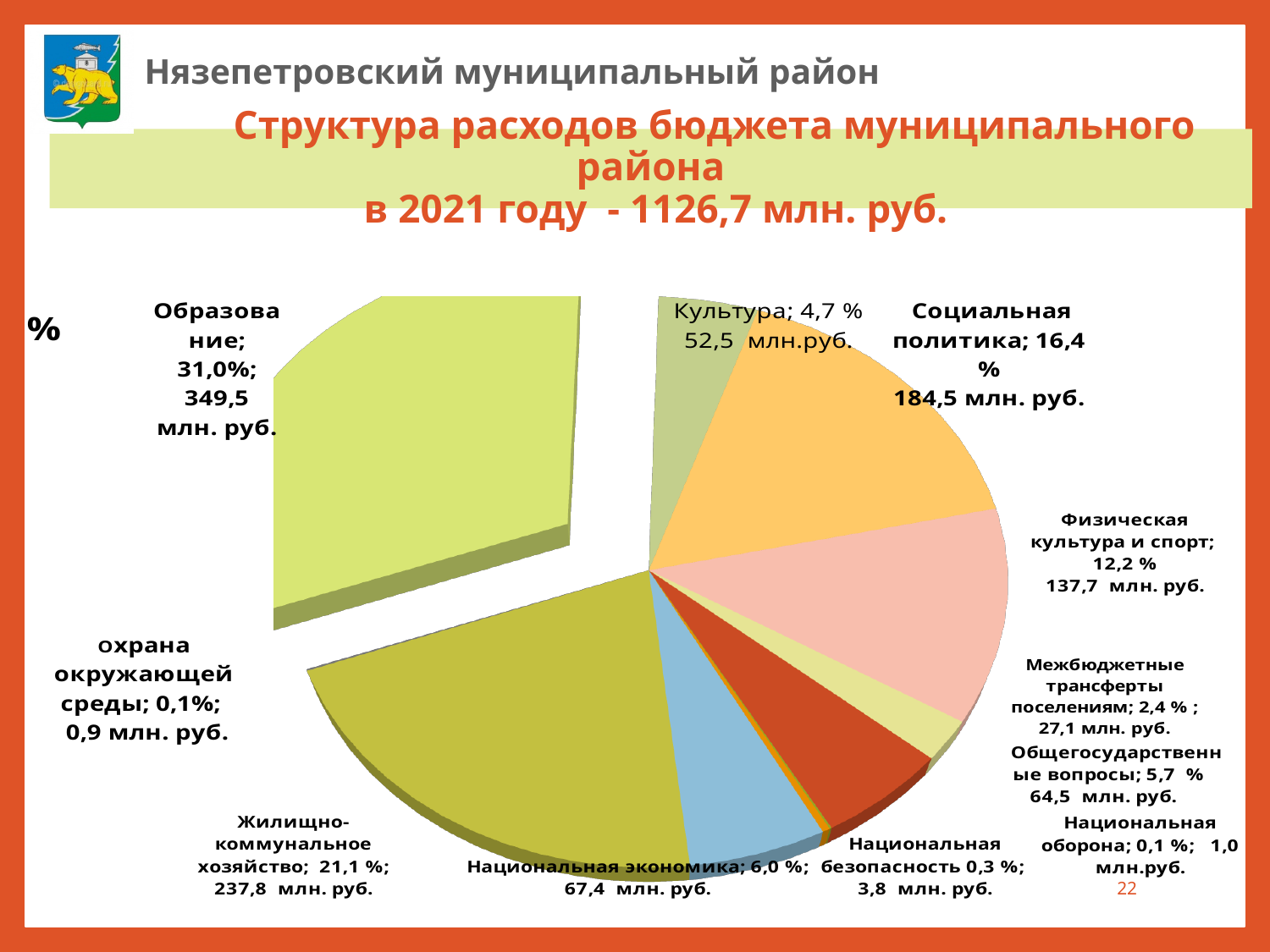
What total budget expenditure for 2021 is stated in the chart title? 1126,7 млн. руб. Which category has the smallest amount in млн. руб.? охрана окружающей среды Which category has the largest share of the budget expenditure? Образование What is the amount in млн. руб. for Социальная политика? 184,5 млн. руб. How many categories (slices) does the pie chart show? 11 What is the difference in млн. руб. between Образование and Жилищно-коммунальное хозяйство? 111,7 млн. руб. Which is larger: the amount for Национальная экономика or for Общегосударственные вопросы? Национальная экономика What share of the budget expenditure goes to Физическая культура и спорт? 12,2 % What is the amount in млн. руб. for Культура? 52,5 млн.руб. What is the amount in млн. руб. for Жилищно-коммунальное хозяйство? 237,8 млн. руб. What share of the budget expenditure goes to Образование? 31,0% What kind of chart is shown on the slide? pie chart